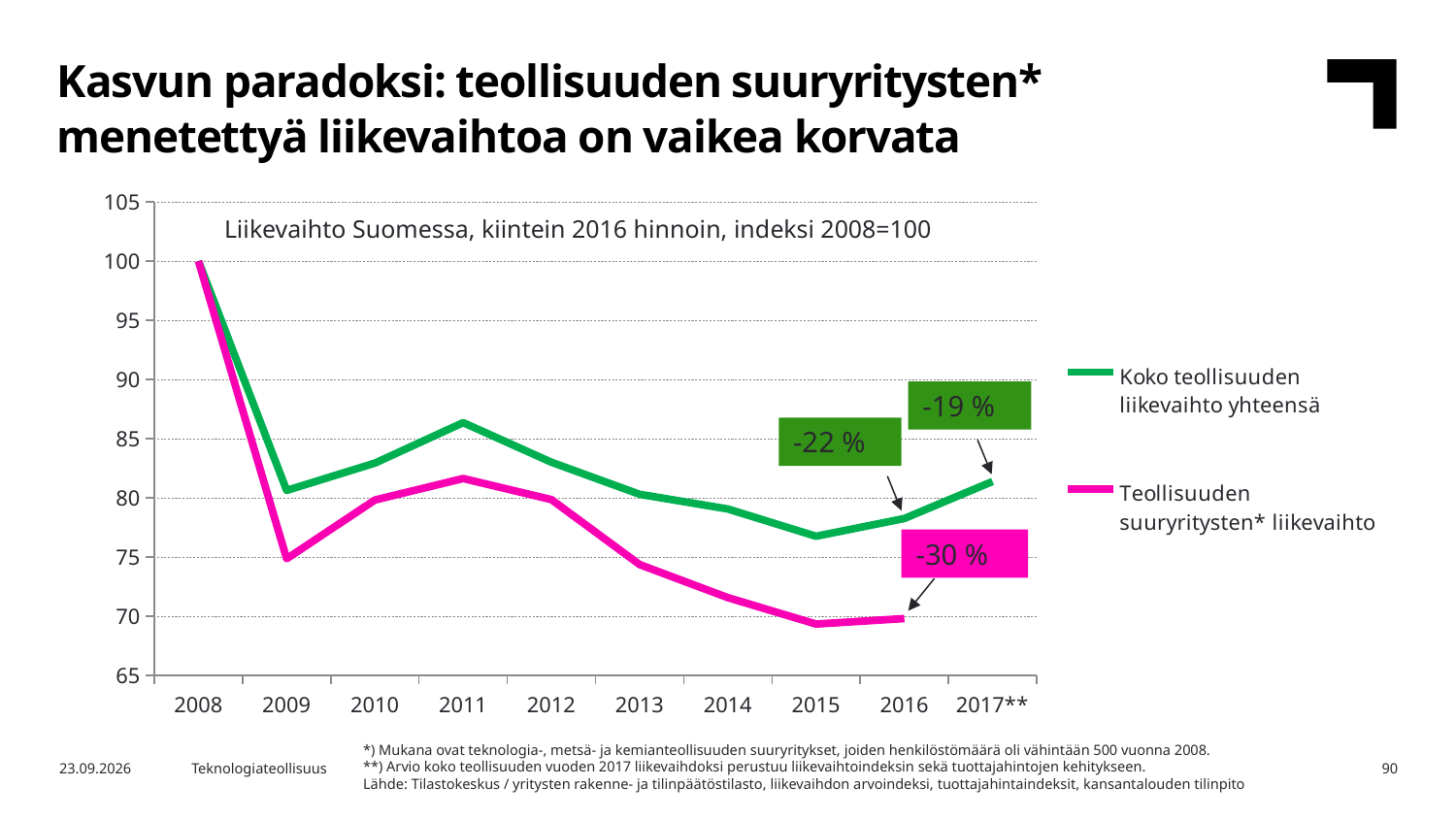
What percentage change is annotated next to the Koko teollisuuden liikevaihto yhteensä line at 2016? -22 % Is the value for Koko teollisuuden liikevaihto yhteensä in 2015 greater or less than 80? less How many series does the legend list? 2 In which year does the Koko teollisuuden liikevaihto yhteensä series reach its highest value? 2008 In 2015, which series has the higher value: Koko teollisuuden liikevaihto yhteensä or Teollisuuden suuryritysten* liikevaihto? Koko teollisuuden liikevaihto yhteensä What is the index value of both series in 2008? 100 Is the value for Koko teollisuuden liikevaihto yhteensä in 2011 greater or less than 85? greater What percentage change is annotated next to the Teollisuuden suuryritysten* liikevaihto line at 2016? -30 % What percentage change is annotated next to the Koko teollisuuden liikevaihto yhteensä line at 2017**? -19 % What kind of chart is shown on the slide? line chart How many years are labelled on the x axis? 10